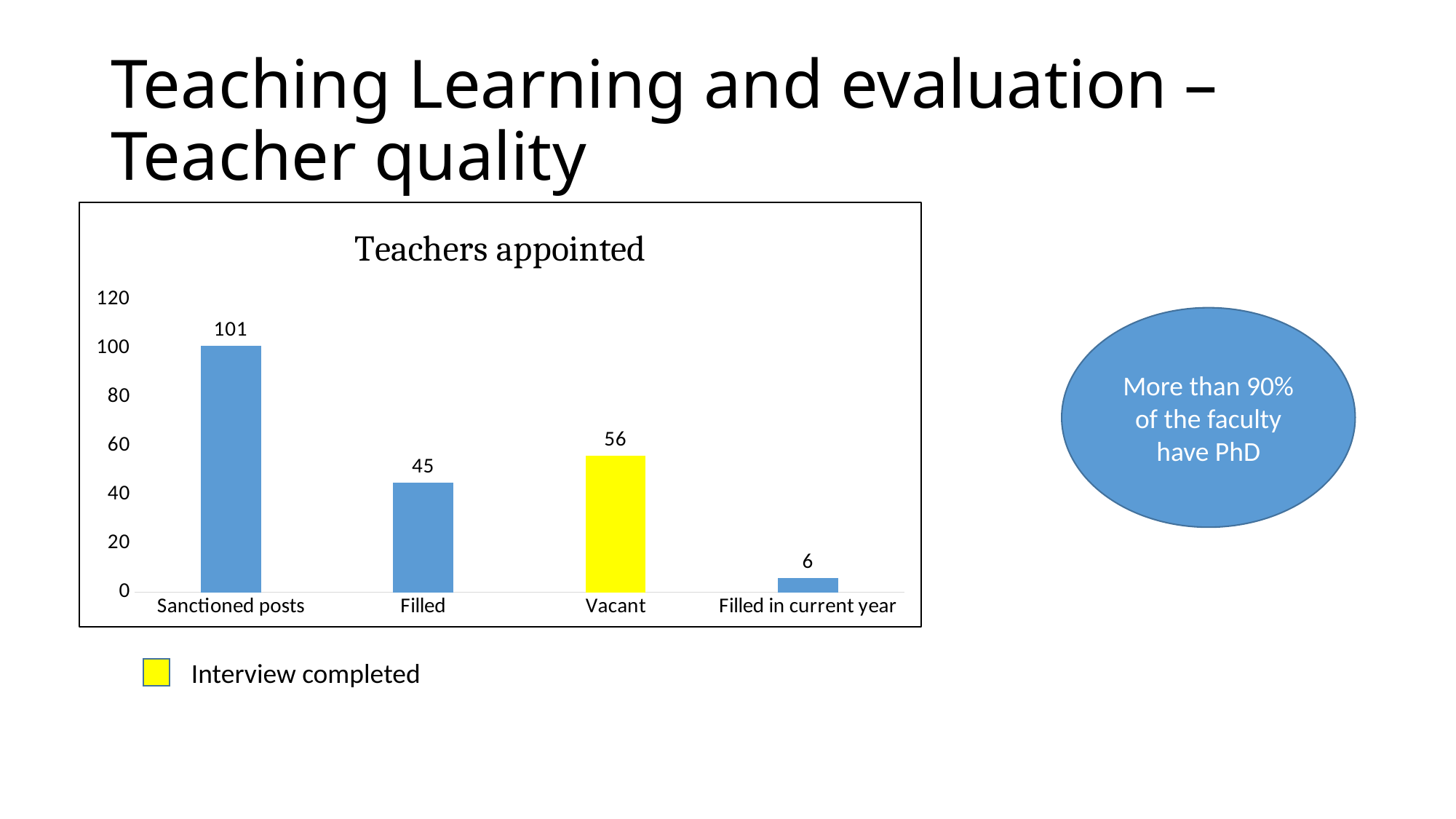
What is the value for Vacant in the Teachers appointed chart? 56 What is the value for Filled in current year in the Teachers appointed chart? 6 What is the difference between Vacant and Filled in the Teachers appointed chart? 11 Which bar in the Teachers appointed chart is coloured yellow? Vacant What kind of chart is the Teachers appointed chart? Bar chart Which category has the lowest value in the Teachers appointed chart? Filled in current year Which category has the highest value in the Teachers appointed chart? Sanctioned posts What is the difference between Sanctioned posts and Filled in the Teachers appointed chart? 56 Which is larger in the Teachers appointed chart, Filled or Vacant? Vacant How many categories are shown in the Teachers appointed chart? 4 What is the value for Sanctioned posts in the Teachers appointed chart? 101 What is the value for Filled in the Teachers appointed chart? 45